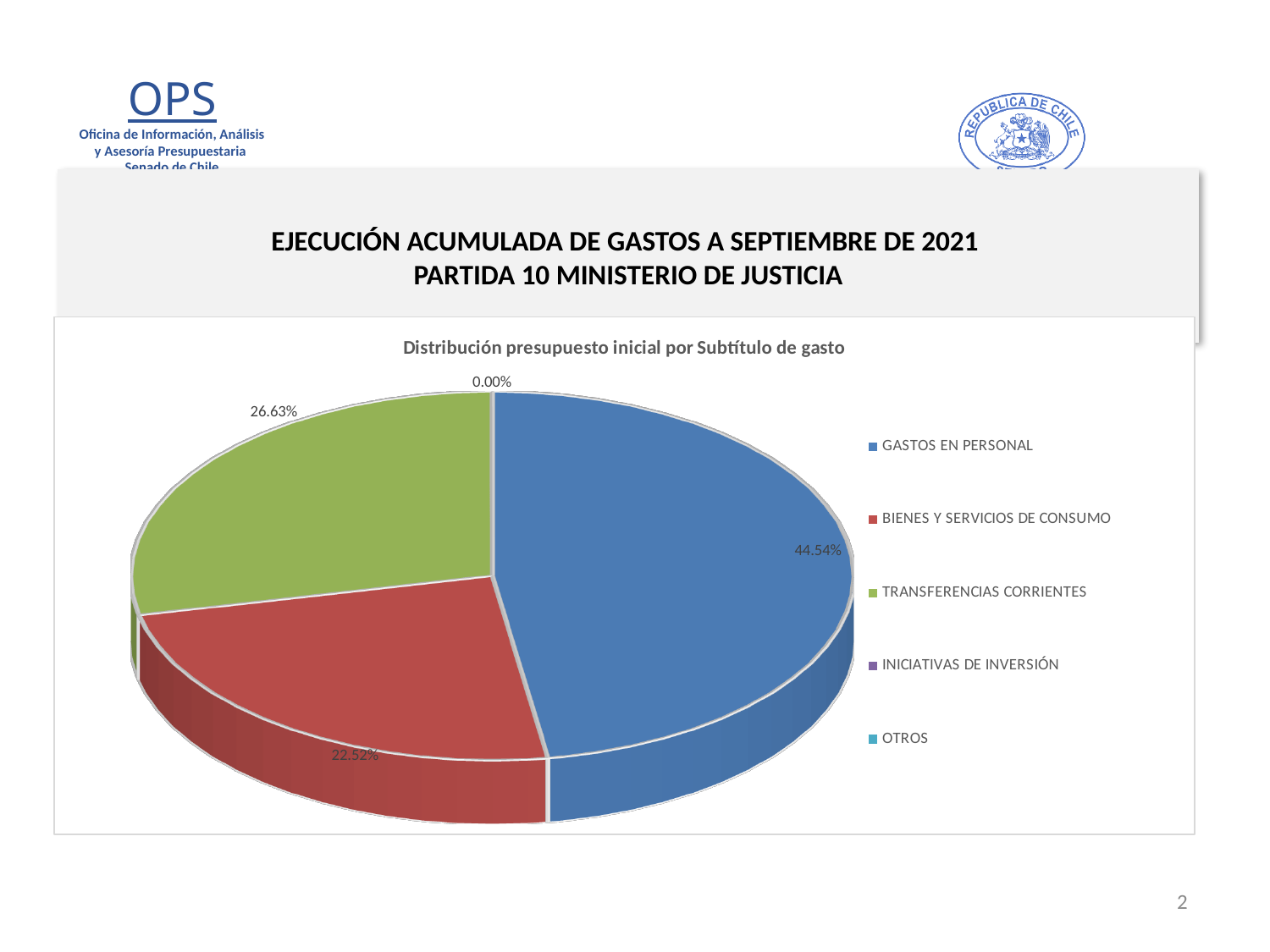
What is the title of the chart? Distribución presupuesto inicial por Subtítulo de gasto What percentage is shown for GASTOS EN PERSONAL? 44.54% Is the share for GASTOS EN PERSONAL greater or less than 50%? less Which is larger, the share for TRANSFERENCIAS CORRIENTES or the share for BIENES Y SERVICIOS DE CONSUMO? TRANSFERENCIAS CORRIENTES What percentage is shown for BIENES Y SERVICIOS DE CONSUMO? 22.52% What is the difference in percentage points between GASTOS EN PERSONAL and BIENES Y SERVICIOS DE CONSUMO? 22.02 percentage points What is the difference in percentage points between TRANSFERENCIAS CORRIENTES and BIENES Y SERVICIOS DE CONSUMO? 4.11 percentage points What kind of chart is shown on the slide? Pie chart How many categories does the legend list? 5 What percentage is shown for TRANSFERENCIAS CORRIENTES? 26.63% Which category has the largest share of the pie? GASTOS EN PERSONAL What colour is the GASTOS EN PERSONAL slice? Blue